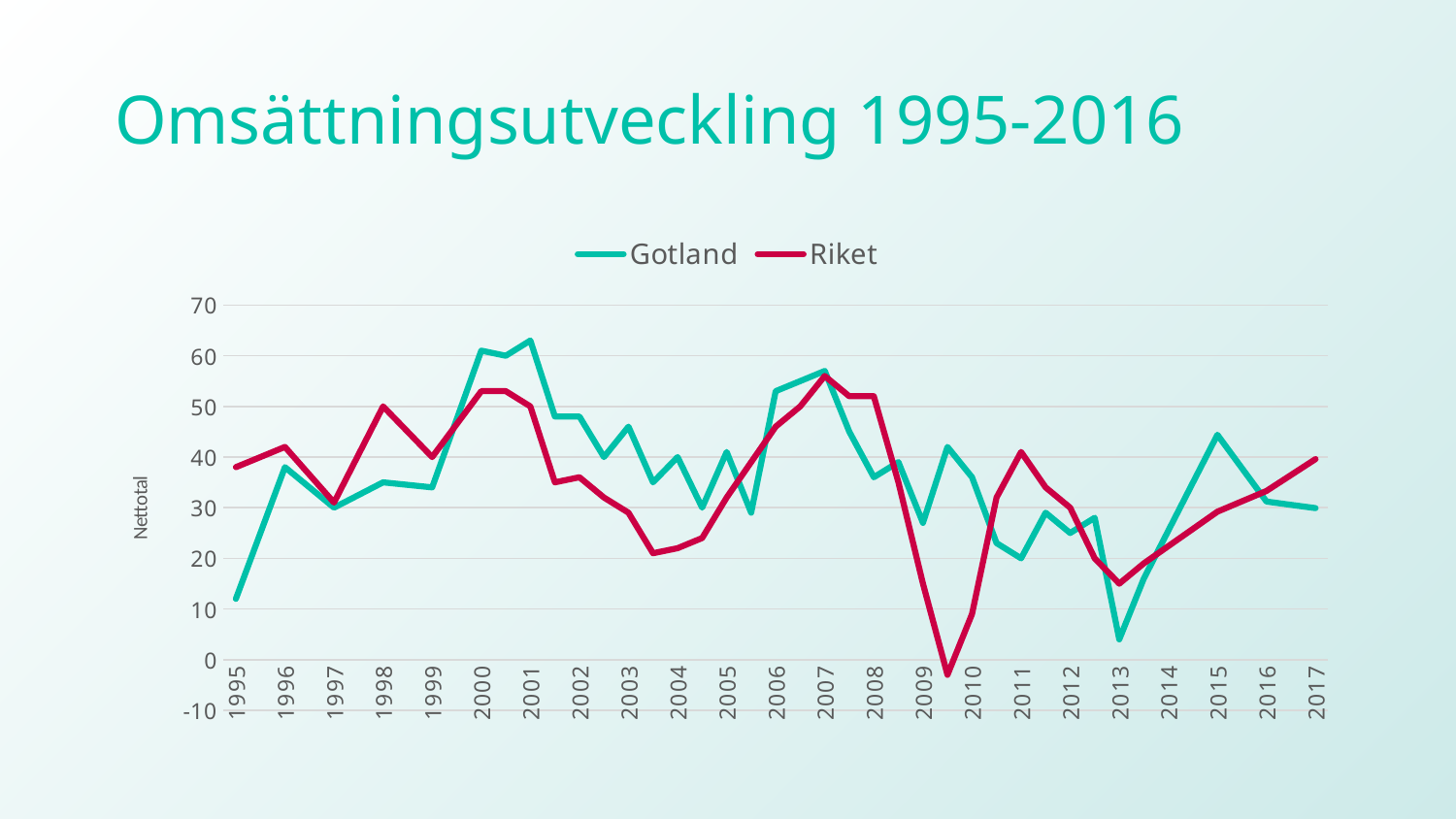
Is the value for Gotland at 2013 greater or less than 10? less Is the value for Gotland at 1995 greater or less than 20? less How many series does the legend list? 2 What are the two series named in the legend? Gotland and Riket What kind of chart is shown on the slide? line chart Is the value for Gotland at 2001 greater or less than 60? greater What is the title of the chart on the slide? Omsättningsutveckling 1995-2016 At 1995, which series has the higher value, Gotland or Riket? Riket How many year labels are shown on the x axis? 23 At 2015, which series has the higher value, Gotland or Riket? Gotland In which year does the Gotland line reach its lowest value? 2013